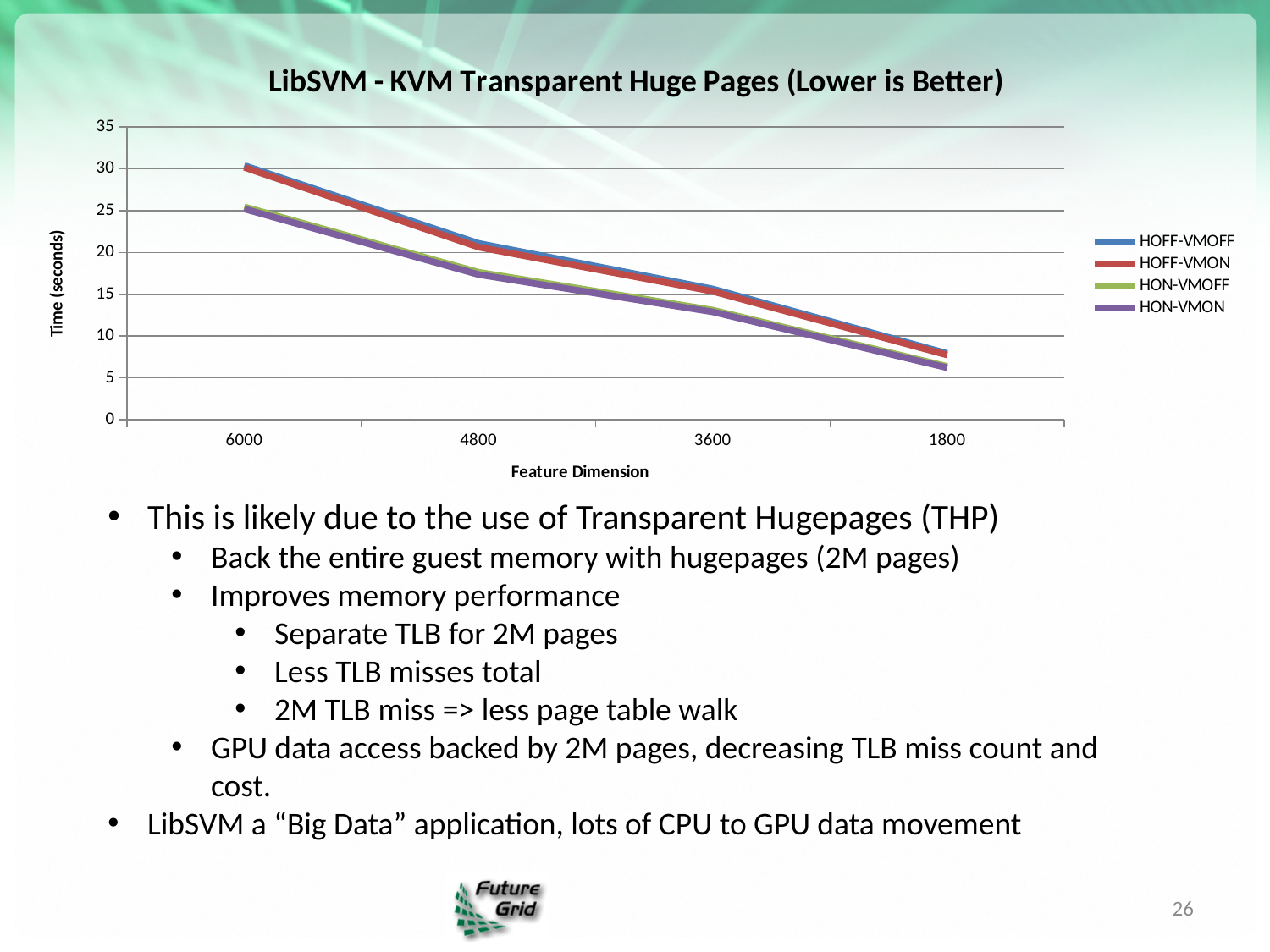
At feature dimension 6000, which is larger: HOFF-VMOFF or HON-VMON? HOFF-VMOFF Is the value for HOFF-VMOFF at feature dimension 6000 greater or less than 25? greater Do the times rise or fall as you move along the x axis from 6000 to 1800? Fall Is the value for HON-VMON at feature dimension 3600 greater or less than 15? less What kind of chart is shown on the slide? Line chart Is the value for HON-VMON at feature dimension 1800 greater or less than 10? less How many series does the legend list? 4 At feature dimension 4800, which is larger: HOFF-VMON or HON-VMOFF? HOFF-VMON At which feature dimension is the time for HOFF-VMOFF highest? 6000 What is the title of the y axis? Time (seconds) How many feature dimension categories are plotted on the x axis? 4